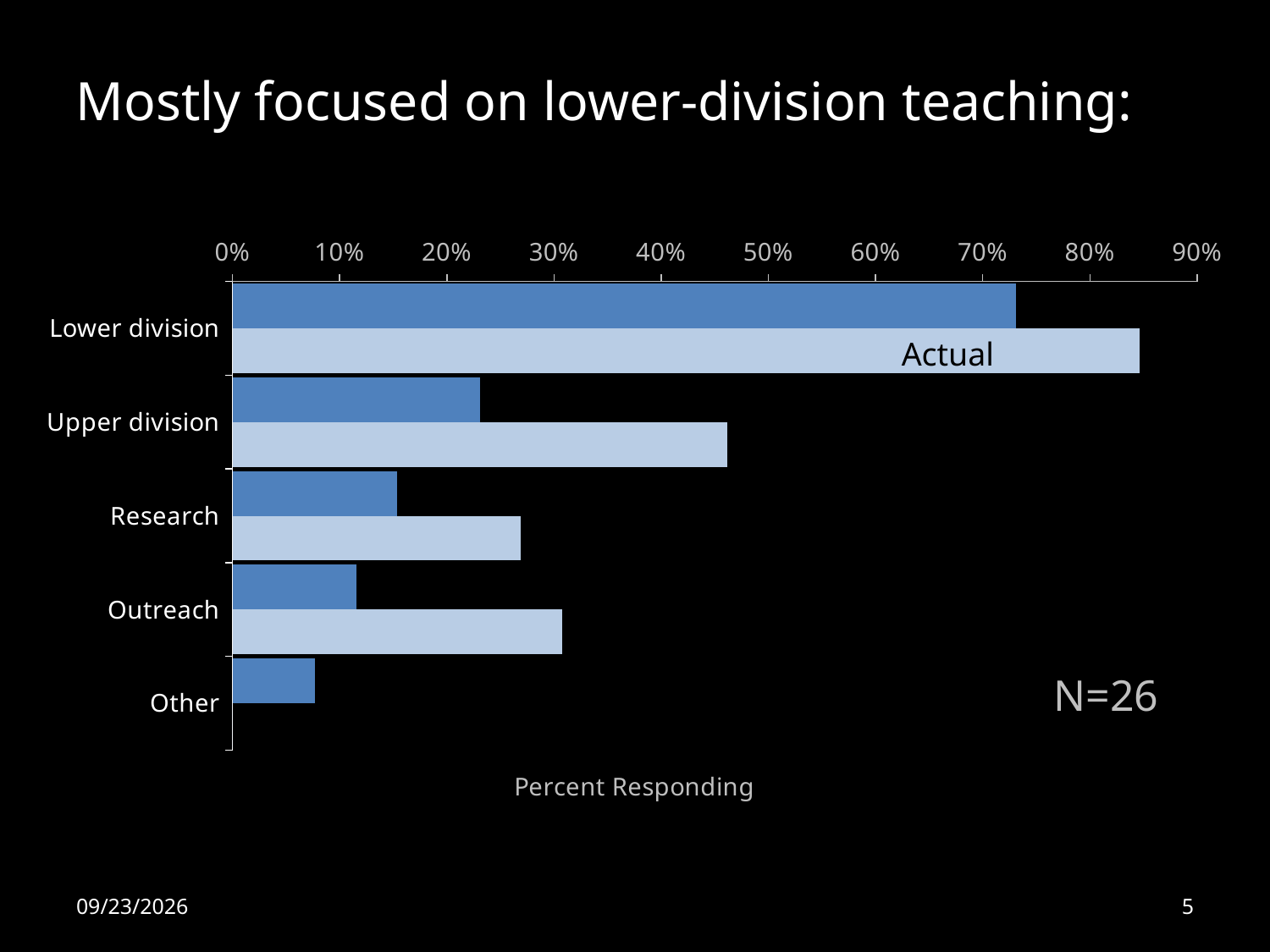
What is the title of the horizontal axis of the chart? Percent Responding Is the dark blue bar for Other greater or less than 10%? less Is the dark blue bar for Lower division greater or less than 70%? greater How many categories are listed on the vertical axis of the chart? 5 Is the dark blue bar for Upper division greater or less than 30%? less Do the dark blue bars get longer or shorter going down the list from Lower division to Other? shorter Which category has the shortest dark blue bar? Other Which category has the longest bars in the chart? Lower division For Upper division, which bar is longer, the dark blue bar or the light blue bar? the light blue bar What kind of chart is shown on the slide? bar chart